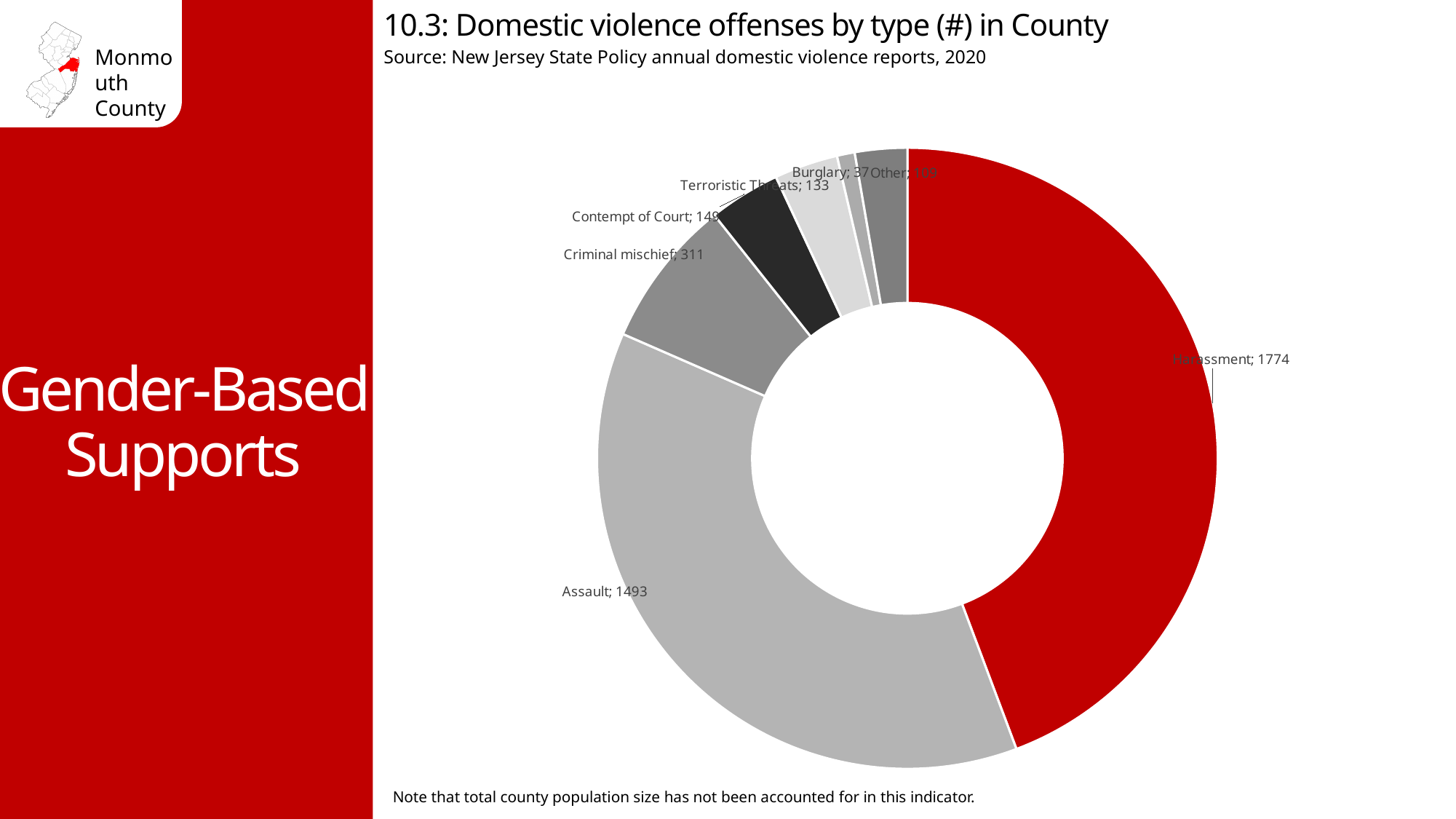
Which offense type has the largest slice of the chart? Harassment What is the value shown for Contempt of Court? 149 What is the value shown for Criminal mischief? 311 How many domestic violence offenses are labeled for Harassment? 1774 What is the value shown for Terroristic Threats? 133 What is the difference between the Criminal mischief value and the Contempt of Court value? 162 What is the value shown for Burglary? 37 What is the difference between the Harassment value and the Assault value? 281 Which is larger, the value for Harassment or the value for Assault? Harassment What is the value shown for Assault? 1493 What colour is the Harassment slice? Red What kind of chart is shown on the slide? Pie chart (doughnut)